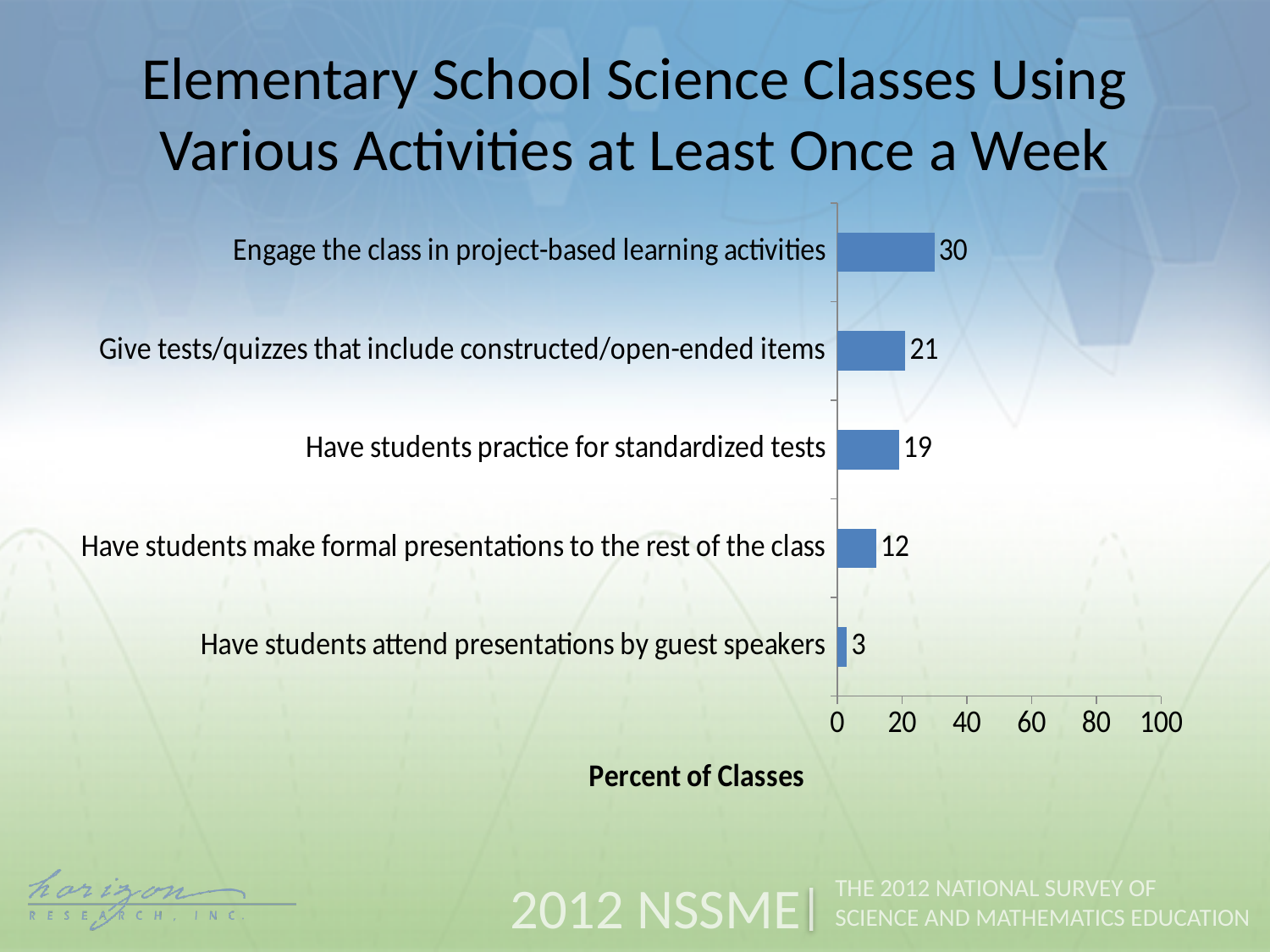
What is the value for 'Have students attend presentations by guest speakers'? 3 Is the value for 'Engage the class in project-based learning activities' greater or less than 40? less What is the label of the horizontal axis? Percent of Classes Which activity has the lowest percent of classes? Have students attend presentations by guest speakers Which activity has the highest percent of classes? Engage the class in project-based learning activities What is the difference between the values for 'Engage the class in project-based learning activities' and 'Have students make formal presentations to the rest of the class'? 18 What is the value for 'Have students practice for standardized tests'? 19 What percent of classes engage the class in project-based learning activities at least once a week? 30 What kind of chart is shown on the slide? Bar chart Which is larger: the value for 'Give tests/quizzes that include constructed/open-ended items' or 'Have students practice for standardized tests'? Give tests/quizzes that include constructed/open-ended items How many activities are shown in the chart? 5 What is the maximum value shown on the horizontal axis? 100